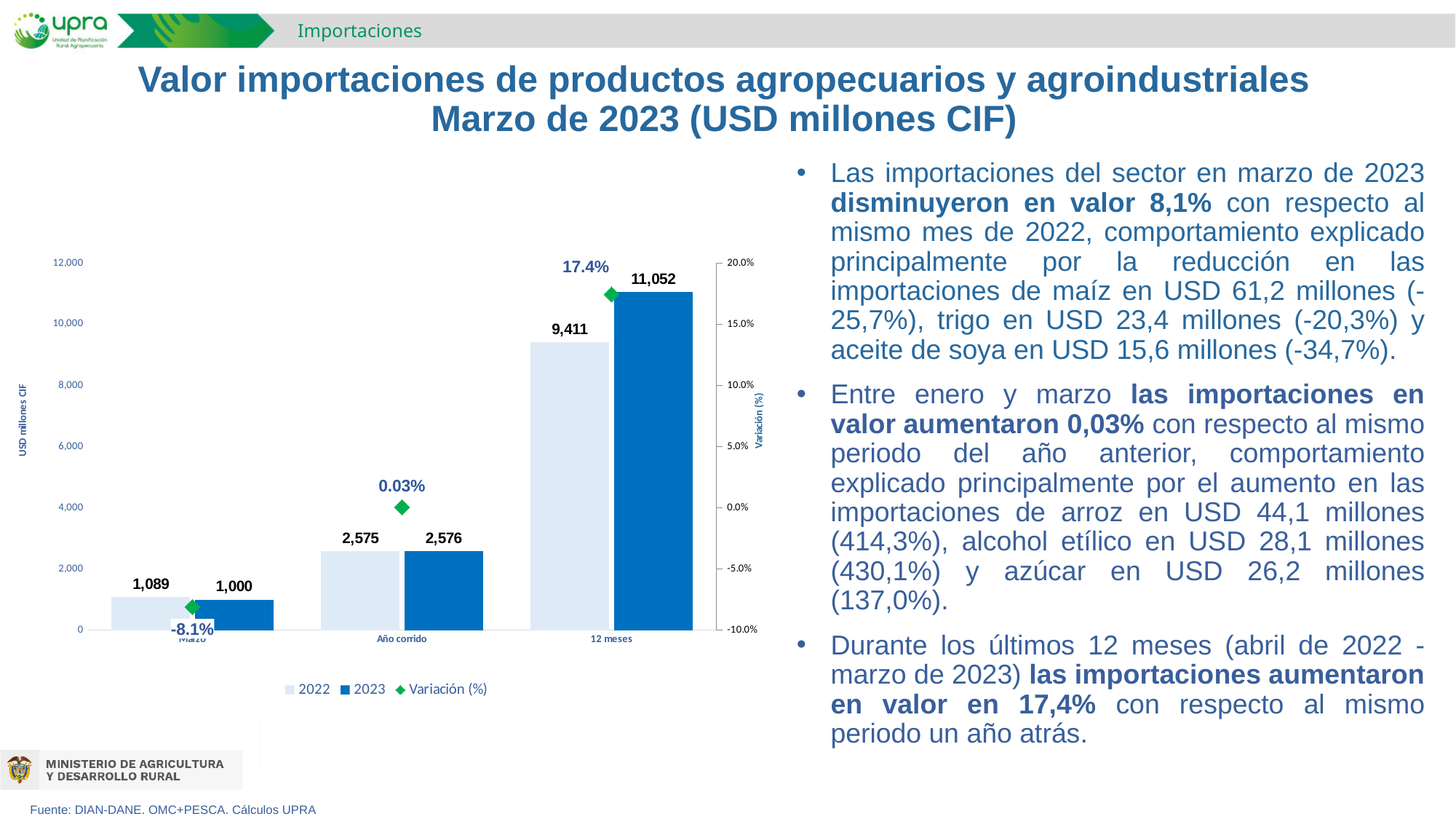
Which is larger for Marzo, the 2022 value or the 2023 value? 2022 What is the difference between the 2023 and 2022 values for 12 meses? 1,641 What kind of chart is shown on the slide? Combination bar and line chart What is the Variación (%) value for Marzo? -8.1% What is the label of the left vertical axis? USD millones CIF What is the Variación (%) value for Año corrido? 0.03% What is the 2023 value for 12 meses? 11,052 What is the 2022 value for Marzo? 1,089 Which category has the highest 2023 value? 12 meses Which category has the lowest 2022 value? Marzo How many categories are shown on the x axis? 3 How many series does the legend list? 3